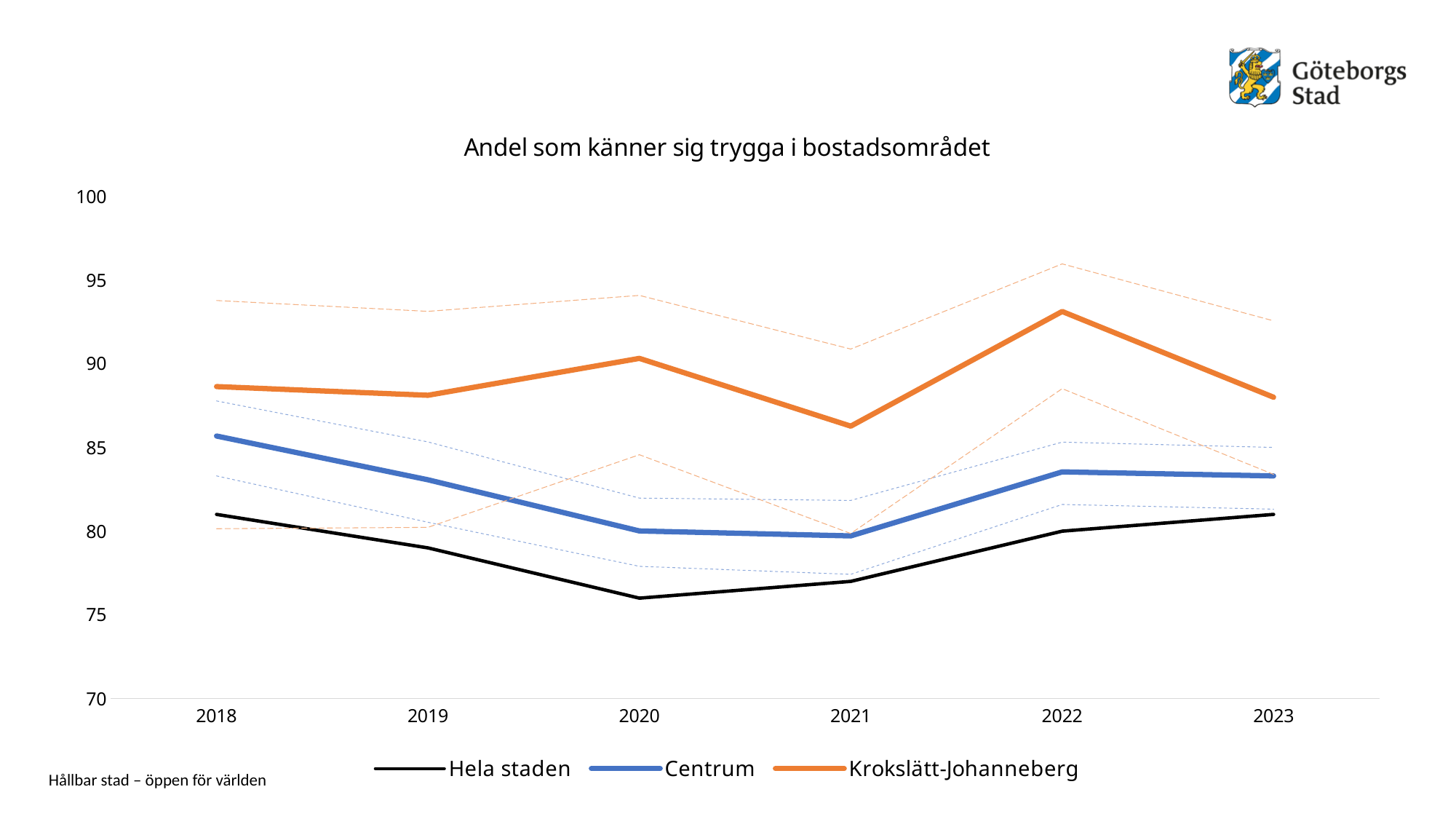
Which series has the highest value in 2022? Krokslätt-Johanneberg What is the title of the chart? Andel som känner sig trygga i bostadsområdet In which year does the Krokslätt-Johanneberg line reach its highest value? 2022 Is the value for Hela staden in 2020 greater or less than 80? less How many series does the legend list? 3 Is the value for Krokslätt-Johanneberg in 2022 greater or less than 90? greater Does the Hela staden line rise or fall from 2018 to 2020? fall Is the value for Krokslätt-Johanneberg in 2021 greater or less than 90? less Which is larger in 2020, the value for Centrum or the value for Krokslätt-Johanneberg? Krokslätt-Johanneberg How many years are shown on the x axis? 6 What kind of chart is shown on the slide? line chart In which year does the Hela staden line reach its lowest value? 2020